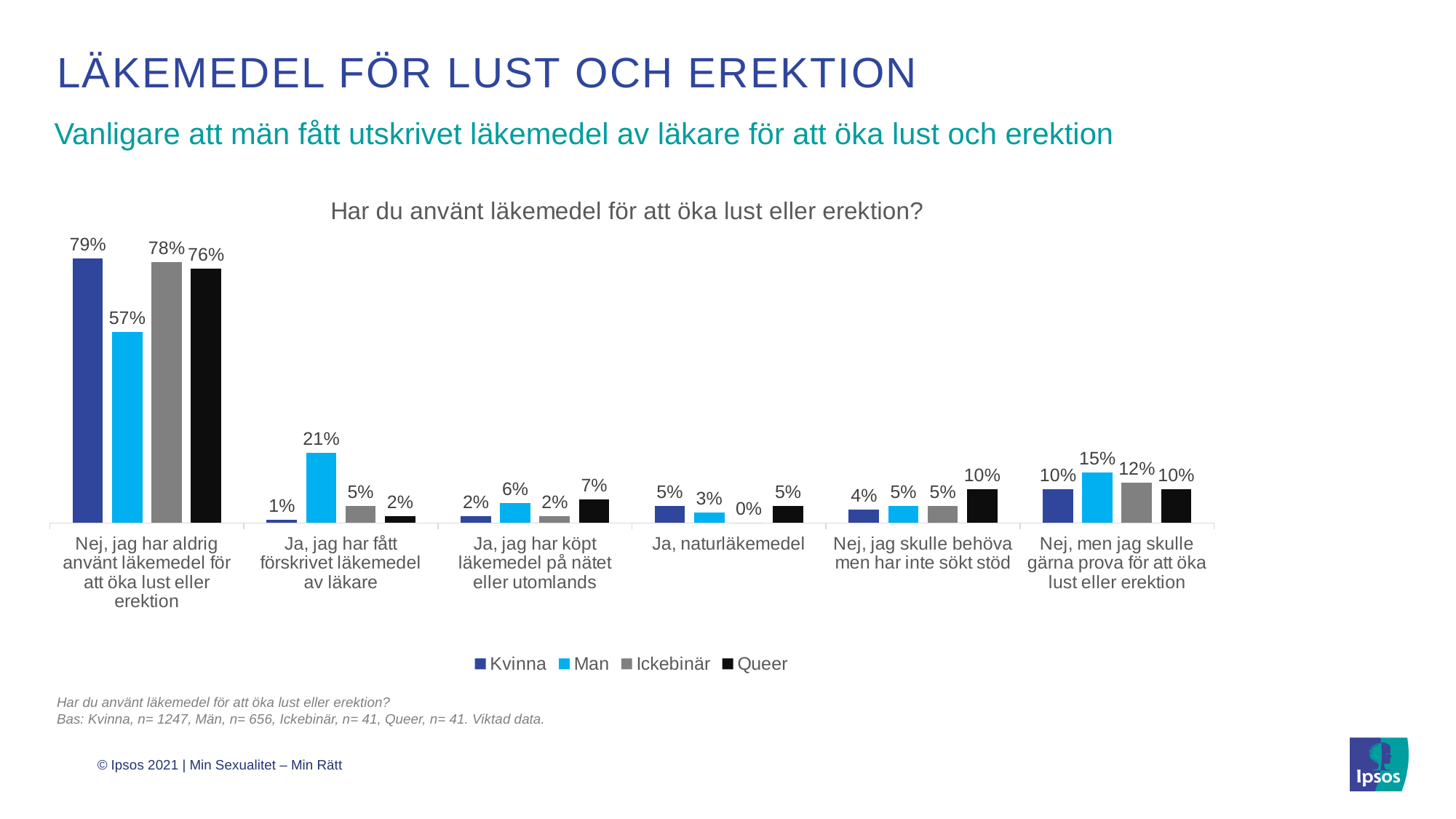
What is the value for Kvinna in the category "Nej, jag har aldrig använt läkemedel för att öka lust eller erektion"? 79% What is the value for Ickebinär in the category "Ja, naturläkemedel"? 0% Which series has the lowest value in the category "Nej, jag har aldrig använt läkemedel för att öka lust eller erektion"? Man What is the difference between the Kvinna and Man values in the category "Nej, jag har aldrig använt läkemedel för att öka lust eller erektion"? 22% Which series has the highest value in the category "Ja, jag har köpt läkemedel på nätet eller utomlands"? Queer What is the value for Queer in the category "Nej, jag skulle behöva men har inte sökt stöd"? 10% What is the value for Man in the category "Ja, jag har fått förskrivet läkemedel av läkare"? 21% What is the title of the chart? Har du använt läkemedel för att öka lust eller erektion? What kind of chart is shown on the slide? Bar chart How many series does the legend list? 4 How many categories are shown on the x axis of the chart? 6 Which is larger in the category "Nej, men jag skulle gärna prova för att öka lust eller erektion": the value for Man or the value for Ickebinär? Man